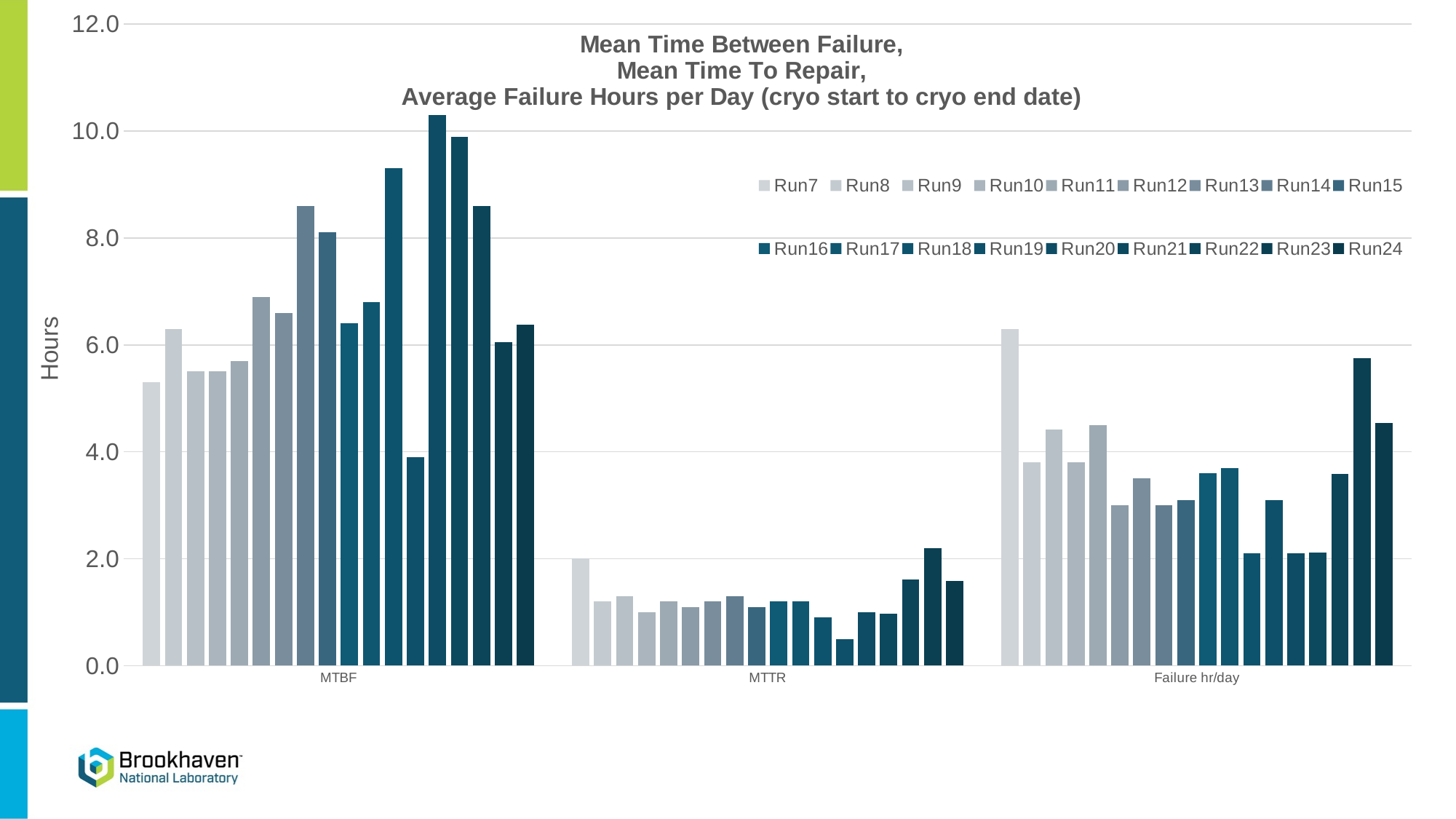
How many series does the legend list? 18 Is the Run7 value for MTTR greater or less than 1.0? greater What kind of chart is shown on the slide? bar chart Is the Run7 value for Failure hr/day greater or less than 6.0? greater Which category contains the tallest bar in the chart? MTBF Is the Run24 value for MTTR greater or less than 2.0? less How many categories are shown on the x axis? 3 What is the highest value shown on the y axis? 12.0 Which category has the lowest bars overall? MTTR What is the label of the y axis? Hours